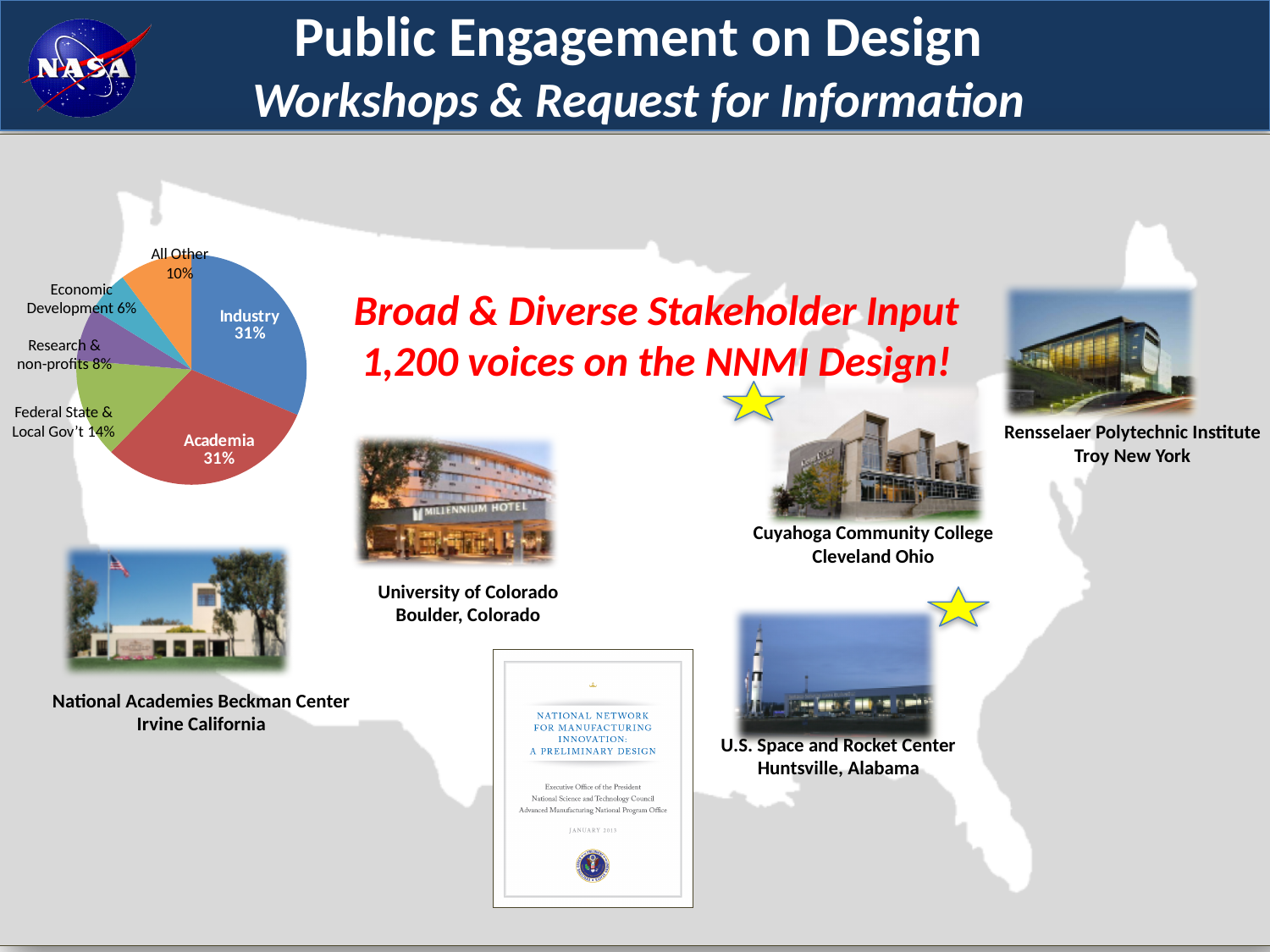
What percentage is shown for All Other? 10% How many slices does the pie chart have? 6 Which category has the smallest slice of the pie? Economic Development What percentage is shown for Federal State & Local Gov't? 14% What share of the pie does Academia represent? 31% What is the difference in percentage points between Industry and Federal State & Local Gov't? 17 What percentage is shown for Economic Development? 6% Which is larger: Federal State & Local Gov't or All Other? Federal State & Local Gov't What share of the pie does Industry represent? 31% What percentage is shown for Research & non-profits? 8% What kind of chart is shown on the slide? pie chart What is the difference in percentage points between All Other and Economic Development? 4